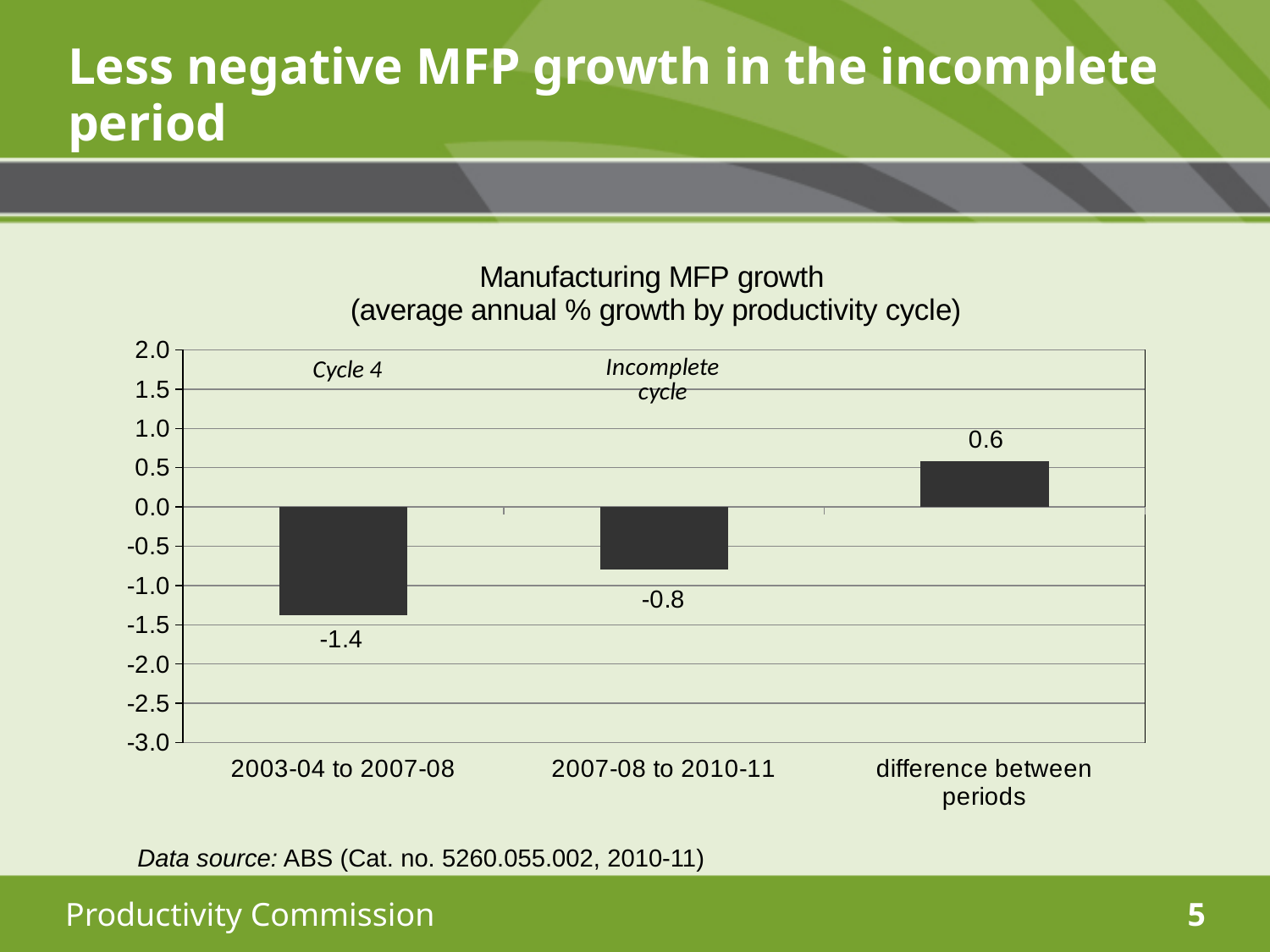
What is the value for 'difference between periods'? 0.6 What kind of chart is this? bar chart Which is larger, the value for 2003-04 to 2007-08 or the value for 2007-08 to 2010-11? 2007-08 to 2010-11 What is the value for 2007-08 to 2010-11? -0.8 Is the value for 'difference between periods' greater or less than 0.5? greater What is the title of the chart? Manufacturing MFP growth (average annual % growth by productivity cycle) Which category has the highest value? difference between periods How many categories are shown on the x axis? 3 Which category has the lowest value? 2003-04 to 2007-08 What is the difference between the values for 2007-08 to 2010-11 and 2003-04 to 2007-08? 0.6 What is the value for 2003-04 to 2007-08? -1.4 Is the value for 2003-04 to 2007-08 greater or less than -1.0? less